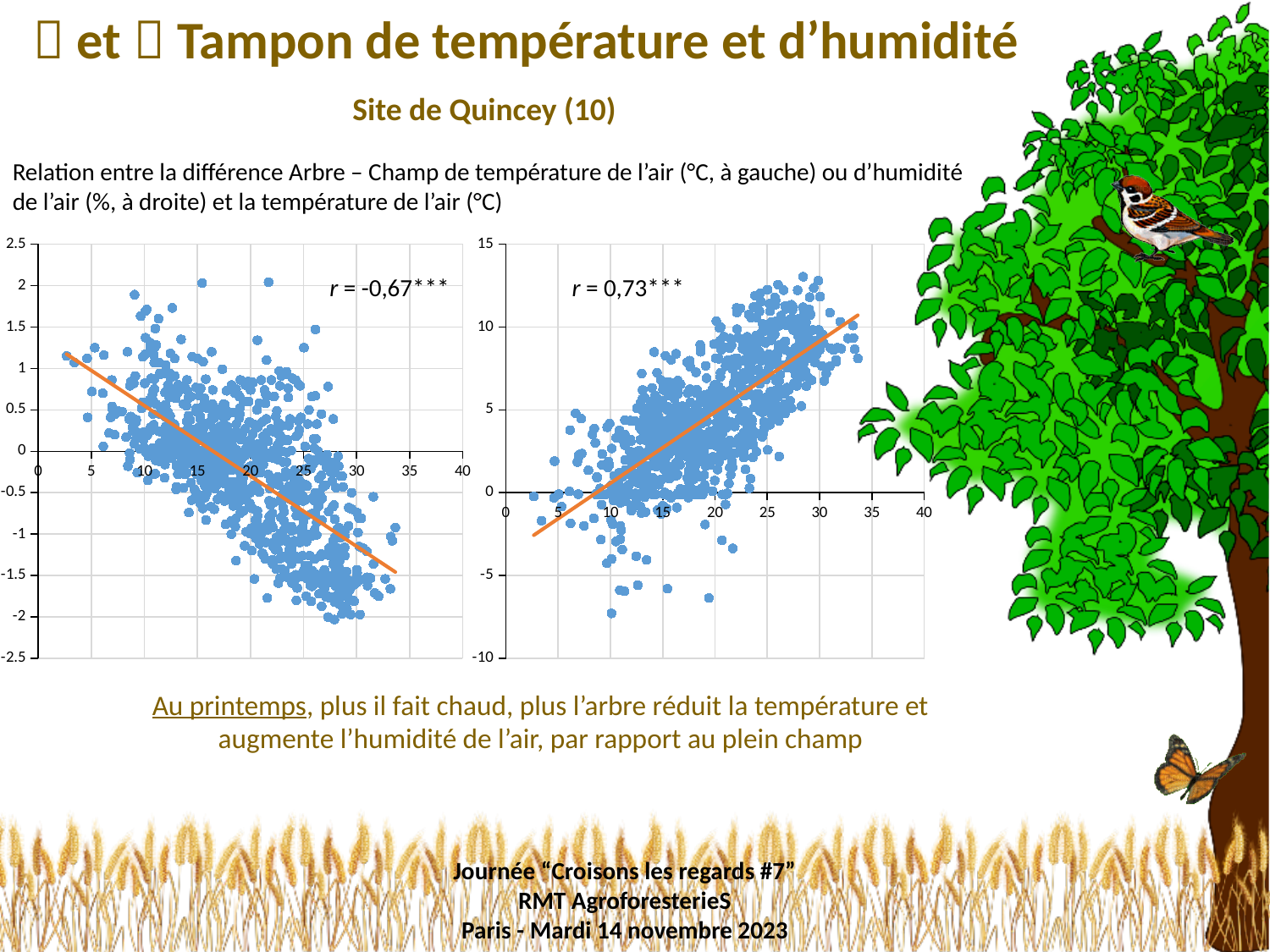
On the left chart, what is the maximum value shown on the y axis? 2.5 What kind of chart is the left chart on the slide? scatter chart What kind of chart is the right chart on the slide? scatter chart On the right chart, is the fitted trend line value at x = 30 greater or less than 5? greater On the left chart (temperature difference), what correlation coefficient r is printed? r = -0,67*** On the right chart (humidity difference), what correlation coefficient r is printed? r = 0,73*** How many charts are shown on the slide? 2 Which chart shows a positive correlation, the left chart or the right chart? the right chart On the left chart, do the plotted values rise or fall as the air temperature on the x axis increases? fall On the right chart, do the plotted values rise or fall as the air temperature on the x axis increases? rise